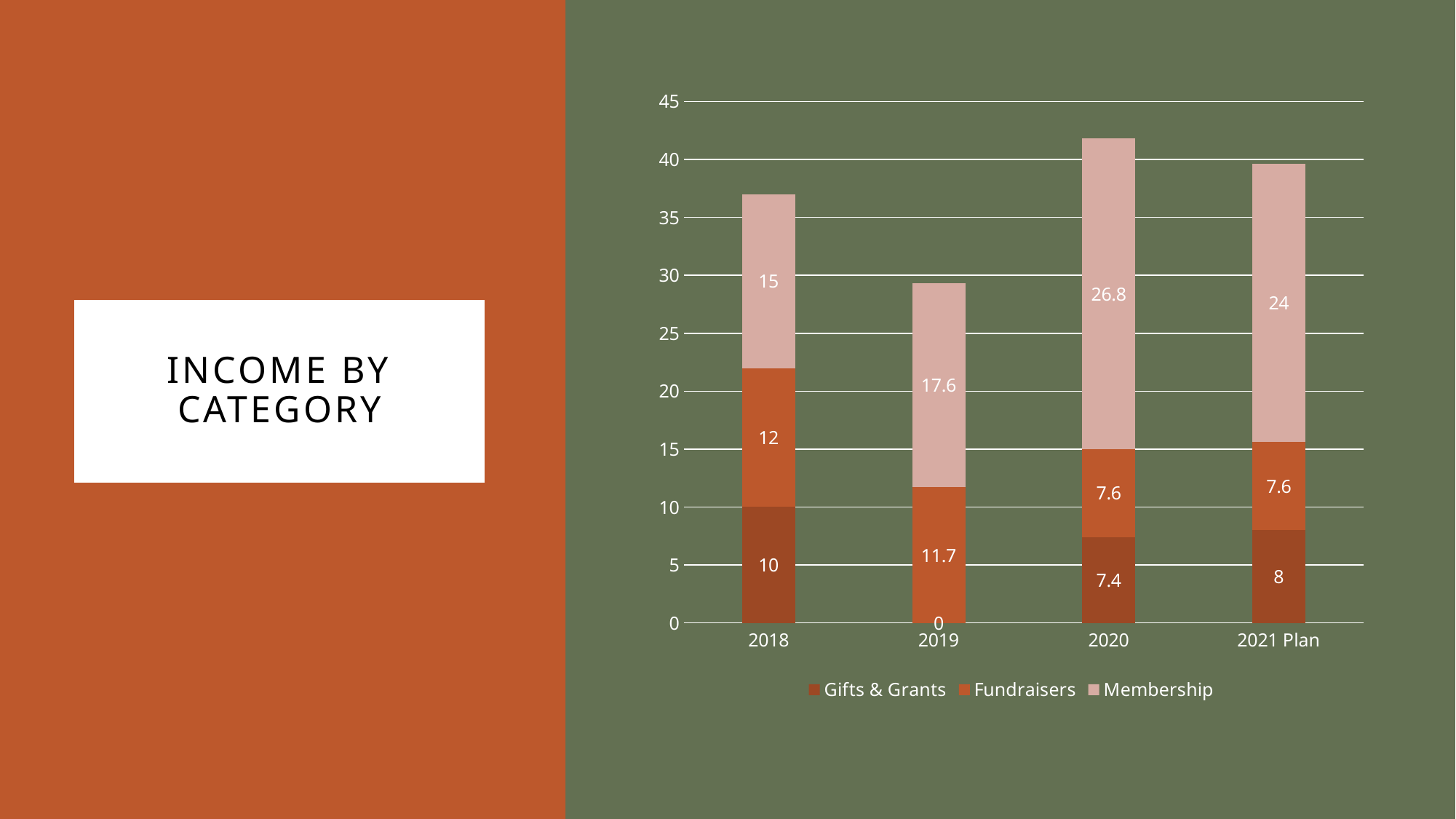
What is the Fundraisers value for 2019? 11.7 What is the Membership value for 2020? 26.8 Which is larger, the Fundraisers value for 2018 or for 2020? 2018 Which year has the highest Membership value? 2020 What is the total of the stacked bar for 2018? 37 What kind of chart is shown on the slide? Stacked bar chart What is the difference between the Membership values for 2020 and 2018? 11.8 How many series does the legend list? 3 Which year has the lowest Gifts & Grants value? 2019 What is the total of the stacked bar for 2021 Plan? 39.6 What is the Gifts & Grants value for 2021 Plan? 8 How many categories are shown on the x axis? 4